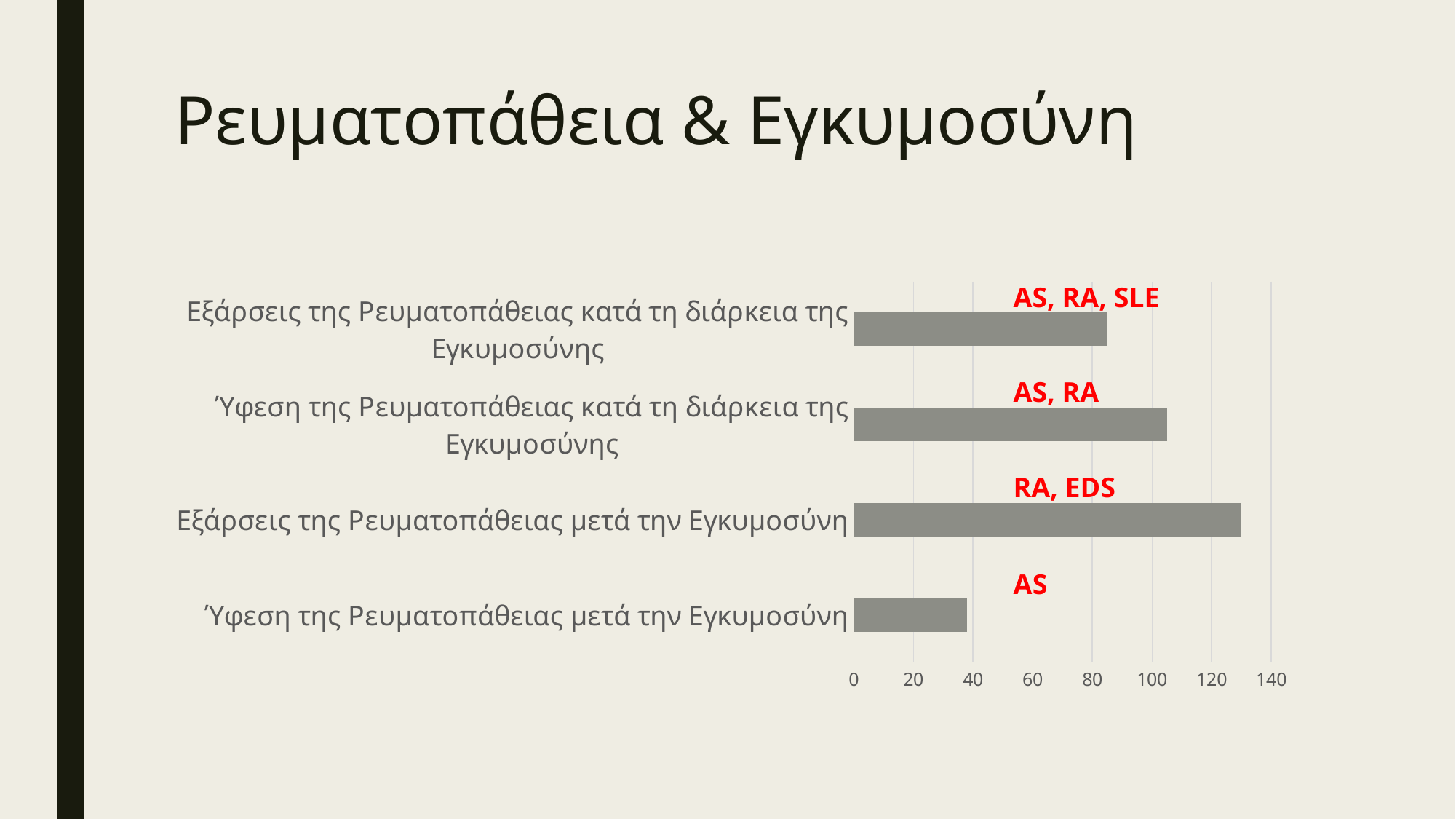
How many categories (bars) does the chart show? 4 Which category has the lowest value? Ύφεση της Ρευματοπάθειας μετά την Εγκυμοσύνη What is the maximum value shown on the horizontal axis? 140 What red annotation is written above the bar for Εξάρσεις της Ρευματοπάθειας μετά την Εγκυμοσύνη? RA, EDS Is the value for Ύφεση της Ρευματοπάθειας κατά τη διάρκεια της Εγκυμοσύνης greater or less than 100? greater Which is larger: the value for Ύφεση της Ρευματοπάθειας κατά τη διάρκεια της Εγκυμοσύνης or the value for Εξάρσεις της Ρευματοπάθειας κατά τη διάρκεια της Εγκυμοσύνης? Ύφεση της Ρευματοπάθειας κατά τη διάρκεια της Εγκυμοσύνης Which is larger: the value for Εξάρσεις της Ρευματοπάθειας μετά την Εγκυμοσύνη or the value for Ύφεση της Ρευματοπάθειας μετά την Εγκυμοσύνη? Εξάρσεις της Ρευματοπάθειας μετά την Εγκυμοσύνη What kind of chart is shown on the slide? bar chart Which category has the highest value? Εξάρσεις της Ρευματοπάθειας μετά την Εγκυμοσύνη Is the value for Εξάρσεις της Ρευματοπάθειας μετά την Εγκυμοσύνη greater or less than 120? greater Is the value for Εξάρσεις της Ρευματοπάθειας κατά τη διάρκεια της Εγκυμοσύνης greater or less than 100? less